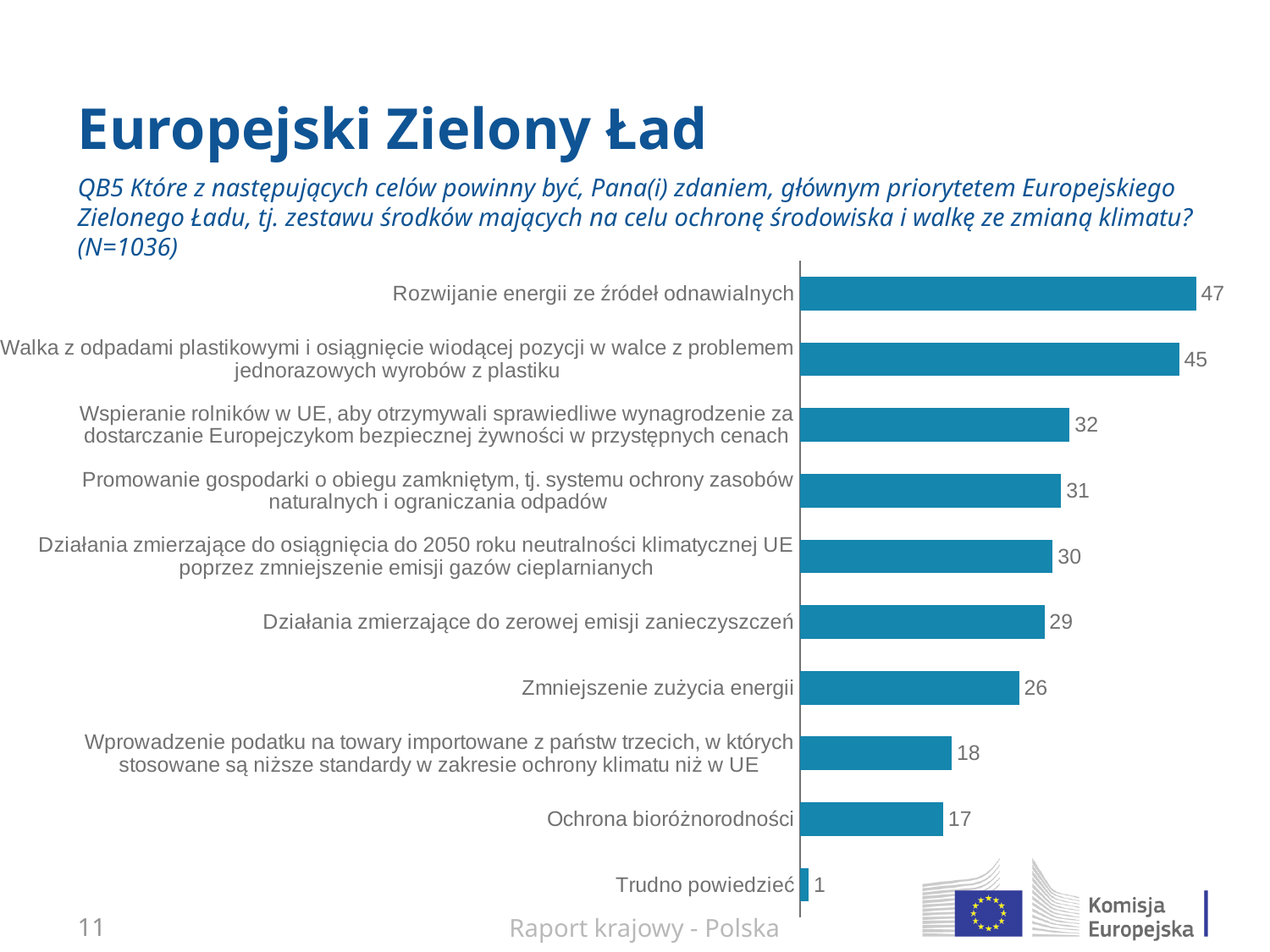
What kind of chart is shown on the slide? Bar chart What is the value for "Zmniejszenie zużycia energii"? 26 Which category has the highest value? Rozwijanie energii ze źródeł odnawialnych What is the title of the slide containing the chart? Europejski Zielony Ład How many categories are shown in the chart? 10 What is the value for "Działania zmierzające do zerowej emisji zanieczyszczeń"? 29 Which is larger: the value for "Zmniejszenie zużycia energii" or the value for "Ochrona bioróżnorodności"? Zmniejszenie zużycia energii What is the difference between the values for "Wprowadzenie podatku na towary importowane z państw trzecich, w których stosowane są niższe standardy w zakresie ochrony klimatu niż w UE" and "Ochrona bioróżnorodności"? 1 Which category has the lowest value? Trudno powiedzieć What is the value for "Rozwijanie energii ze źródeł odnawialnych"? 47 What is the value for "Ochrona bioróżnorodności"? 17 What is the difference between the values for "Rozwijanie energii ze źródeł odnawialnych" and "Walka z odpadami plastikowymi i osiągnięcie wiodącej pozycji w walce z problemem jednorazowych wyrobów z plastiku"? 2